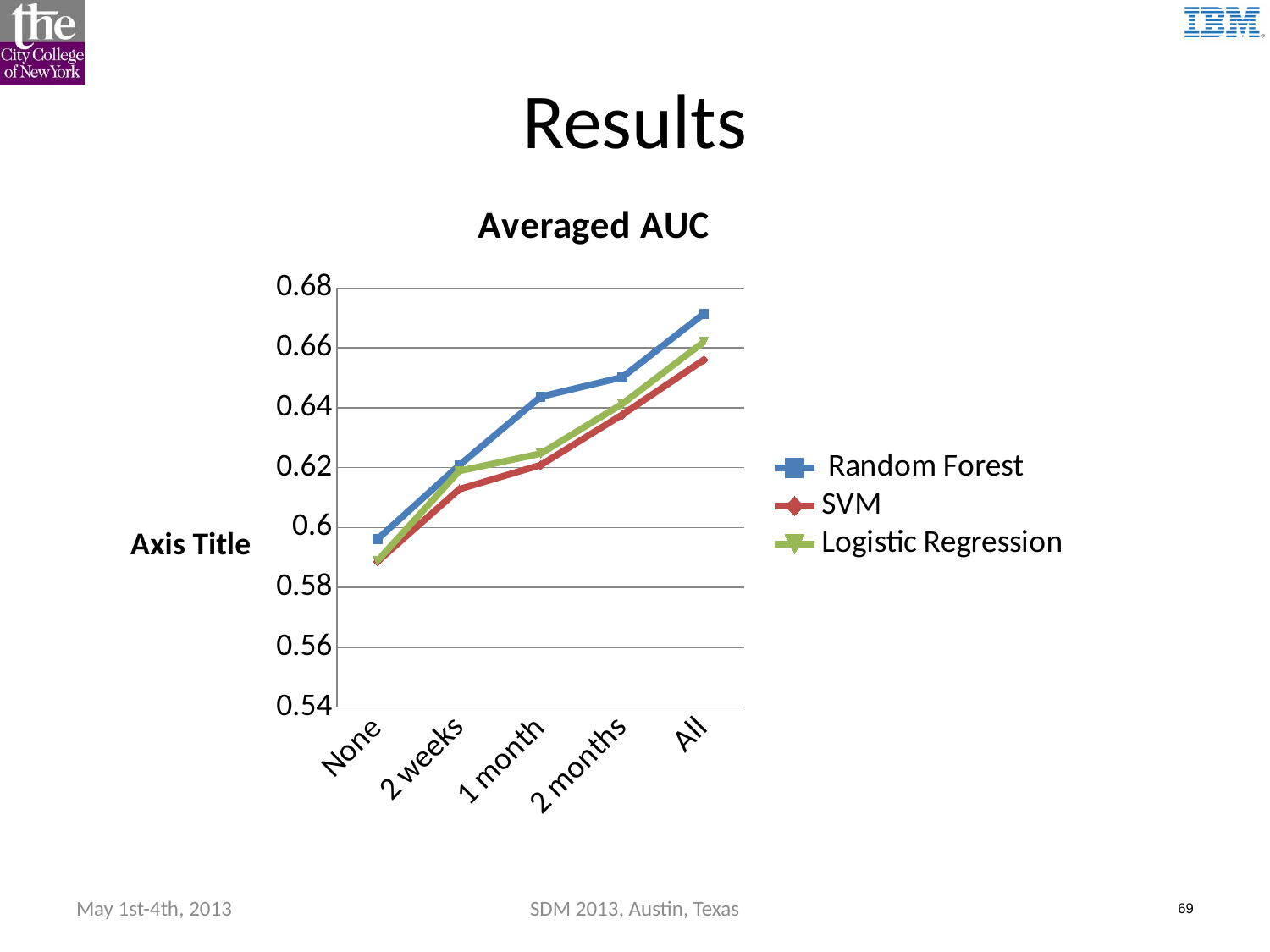
For the Random Forest series, which category has the highest value? All How many categories are shown on the x axis? 5 Is the value for Random Forest at "All" greater or less than 0.66? greater Is the value for SVM at "None" greater or less than 0.6? less How many series does the legend list? 3 Which series has the highest value at the "All" category? Random Forest What kind of chart is shown on the slide? line chart At "1 month", which is larger: Random Forest or SVM? Random Forest What is the title of the chart? Averaged AUC Do the values for the Random Forest series rise or fall from "None" to "All"? rise For the SVM series, which category has the lowest value? None